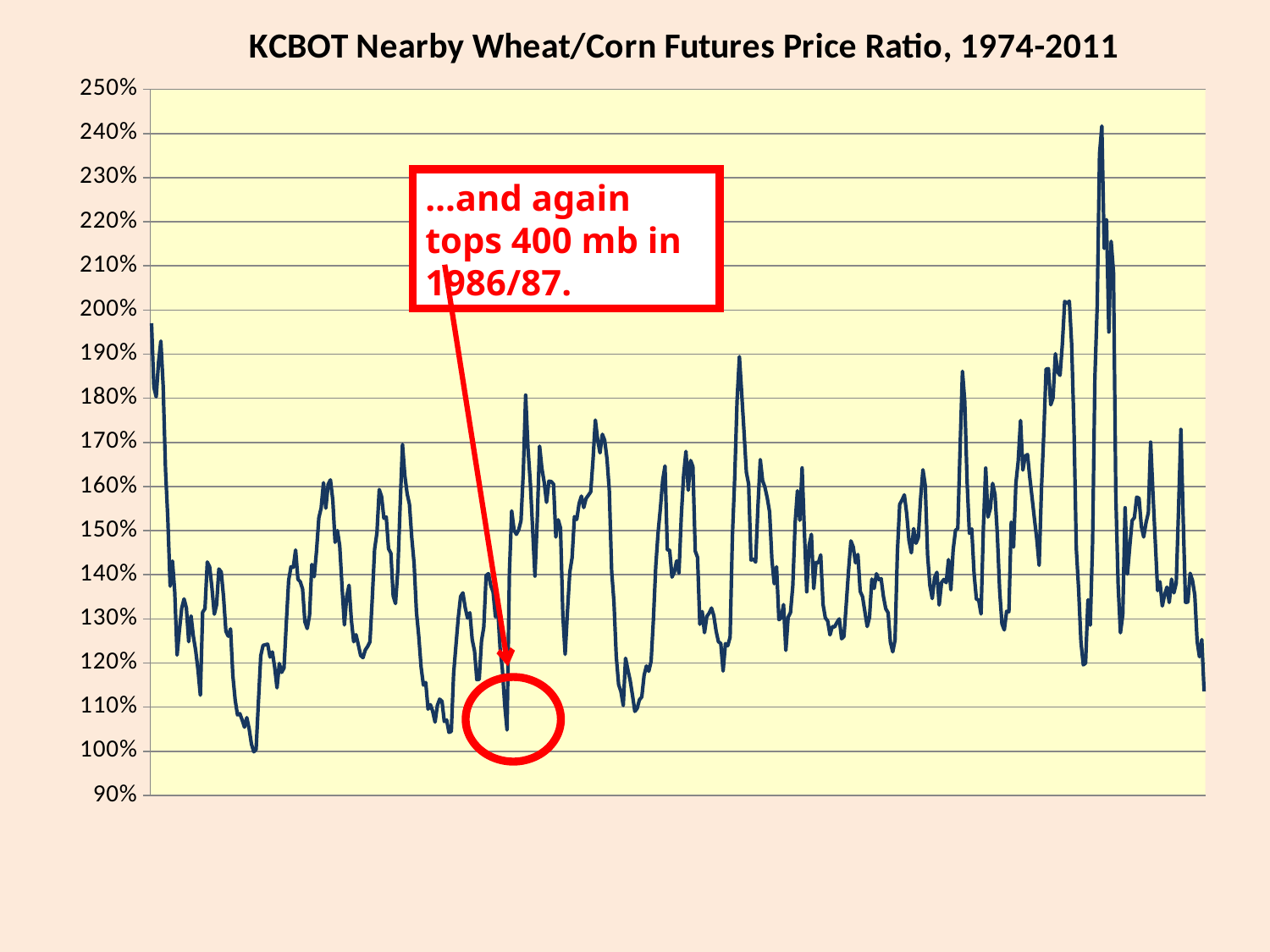
Is the lowest value reached by the line greater or less than 110%? less What is the lowest tick value shown on the vertical axis? 90% What is the title of the chart? KCBOT Nearby Wheat/Corn Futures Price Ratio, 1974-2011 What does the red annotation box on the chart say? ...and again tops 400 mb in 1986/87. What is the highest tick value shown on the vertical axis? 250% Is the value at the point circled in red greater or less than 120%? less Is the highest value reached by the line greater or less than 230%? greater What kind of chart is shown on the slide? line chart